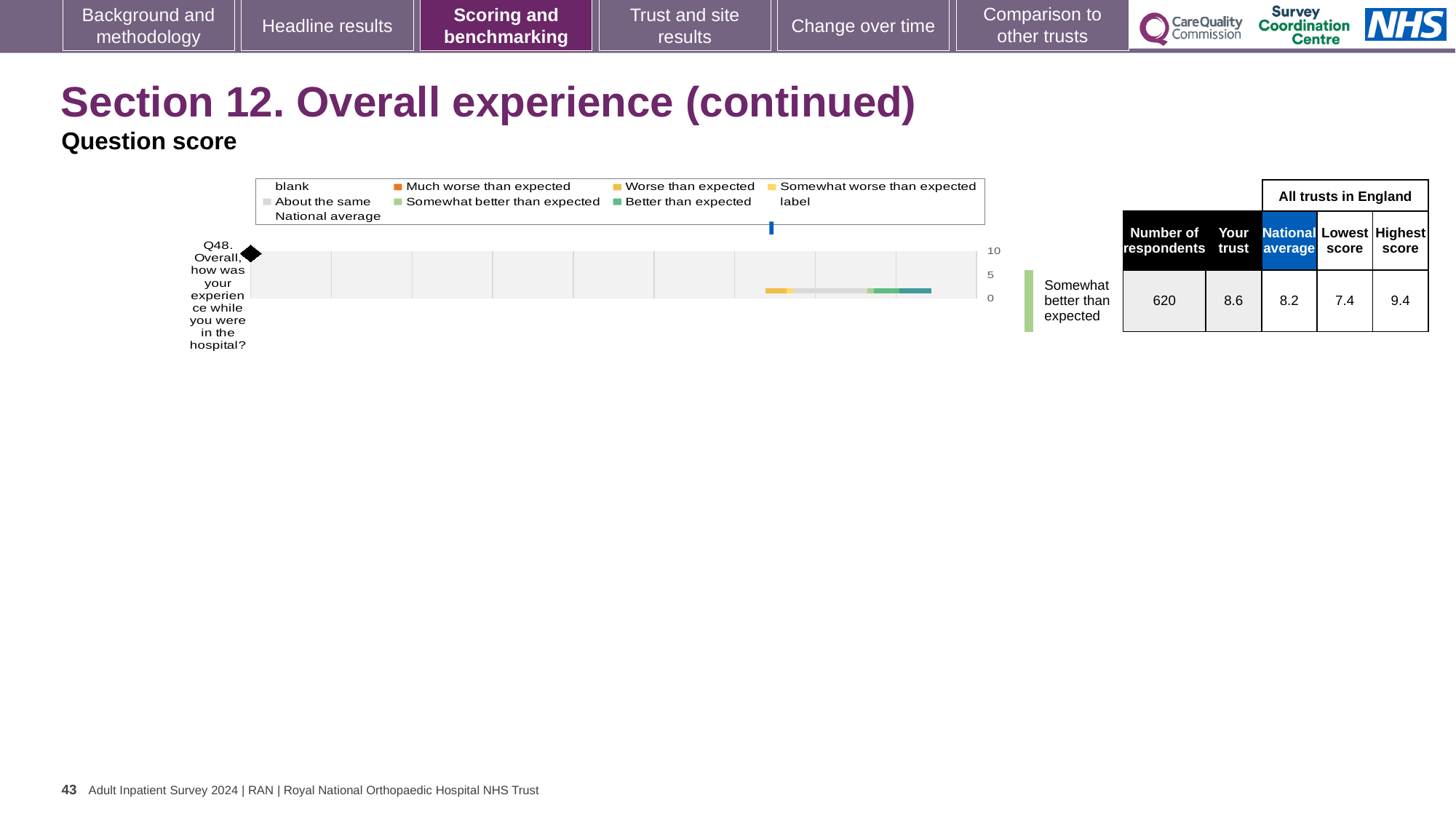
What is the highest value shown on the chart's numeric axis? 10 Is the 'Your trust' score for Q48 higher or lower than the national average? higher What benchmark category is the trust's Q48 score assigned to on the slide? Somewhat better than expected What kind of chart is shown for Q48 on the slide? bar chart According to the table beside the chart, what is the lowest score among all trusts in England for Q48? 7.4 How many questions (categories) are plotted in the chart? 1 What is the difference between the 'Your trust' score and the national average for Q48? 0.4 According to the table beside the chart, what is the 'Your trust' score for Q48? 8.6 According to the table beside the chart, what is the highest score among all trusts in England for Q48? 9.4 According to the table beside the chart, what is the national average score for Q48? 8.2 According to the table beside the chart, how many respondents answered Q48? 620 Which question is plotted in the chart? Q48. Overall, how was your experience while you were in the hospital?